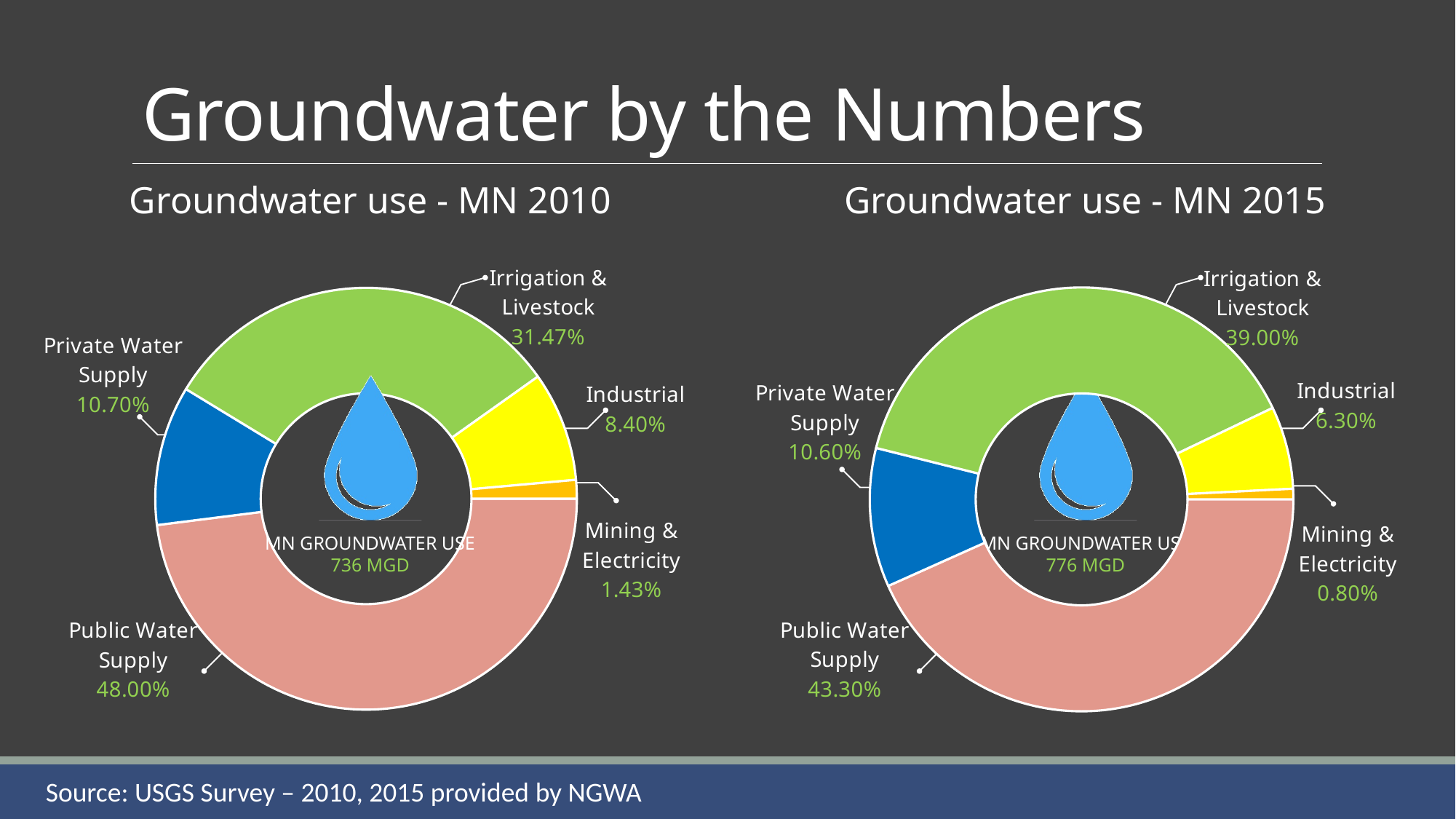
In the 'Groundwater use - MN 2010' chart, which category has the largest share? Public Water Supply In the 'Groundwater use - MN 2015' chart, what is the value for Industrial? 6.30% What colour is the Industrial slice in the 'Groundwater use - MN 2010' chart? Yellow What total groundwater use is shown in the centre of the 'Groundwater use - MN 2015' chart? 776 MGD In the 'Groundwater use - MN 2010' chart, what is the value for Mining & Electricity? 1.43% In the 'Groundwater use - MN 2010' chart, what share does Public Water Supply have? 48.00% What kind of chart is the 'Groundwater use - MN 2010' chart? Doughnut (pie) chart In the 'Groundwater use - MN 2015' chart, what share does Irrigation & Livestock have? 39.00% In the 'Groundwater use - MN 2015' chart, which is larger: Private Water Supply or Industrial? Private Water Supply In the 'Groundwater use - MN 2015' chart, which category has the smallest share? Mining & Electricity How many categories are shown in the 'Groundwater use - MN 2015' chart? 5 In the 'Groundwater use - MN 2010' chart, what is the difference between the Public Water Supply share and the Irrigation & Livestock share? 16.53%